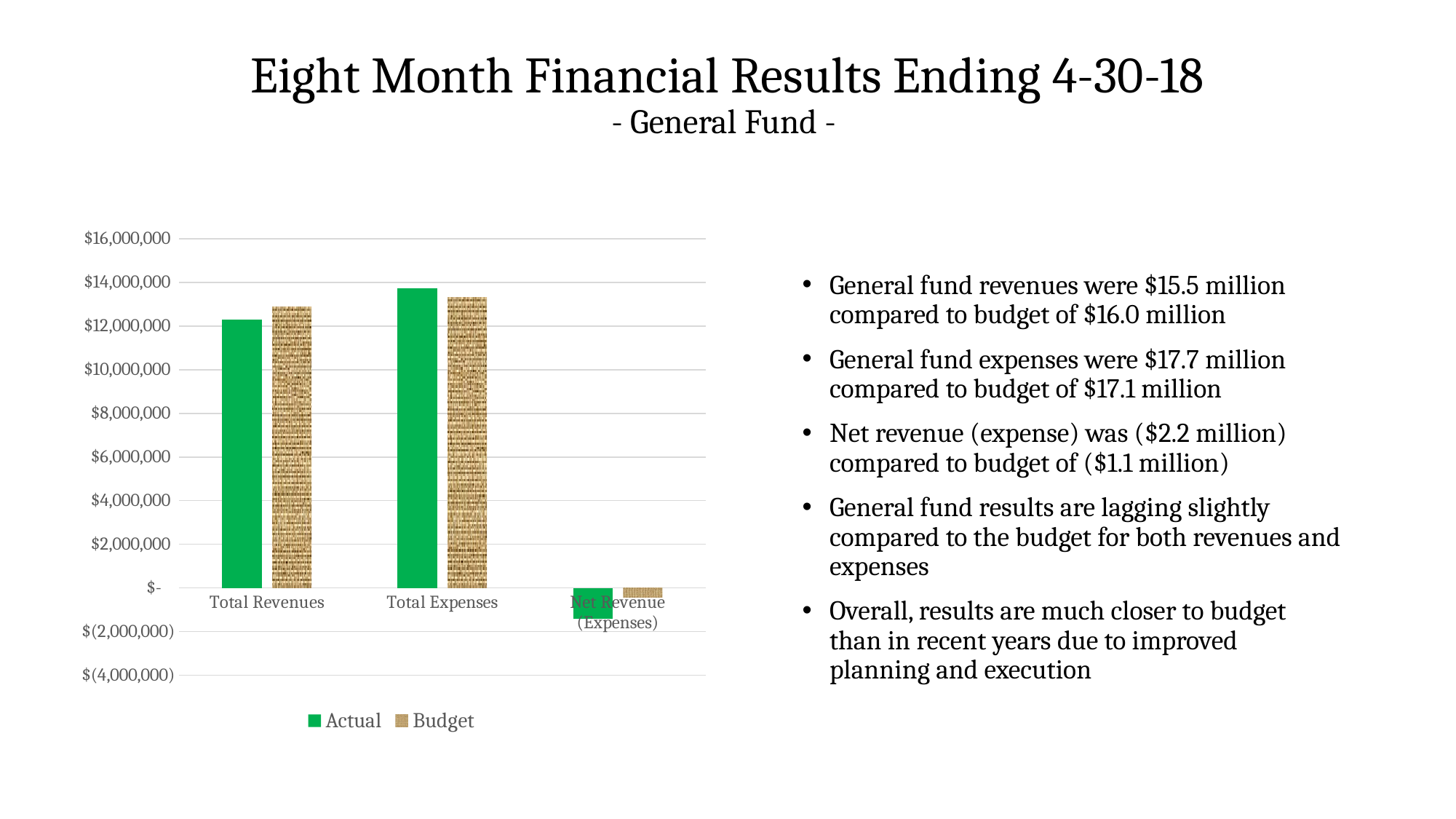
Is the Budget value for Total Expenses greater or less than $14,000,000? less Which category has the highest Actual value in the chart? Total Expenses Is the Actual value for Net Revenue (Expenses) greater or less than $-? less Which series is shown in green in the chart? Actual For Total Expenses, which is larger, the Actual bar or the Budget bar? Actual For Total Revenues, which is larger, the Actual bar or the Budget bar? Budget How many categories are shown on the x axis of the chart? 3 How many series does the chart legend list? 2 What kind of chart is shown on the slide? Bar chart Is the Actual value for Total Revenues greater or less than $14,000,000? less